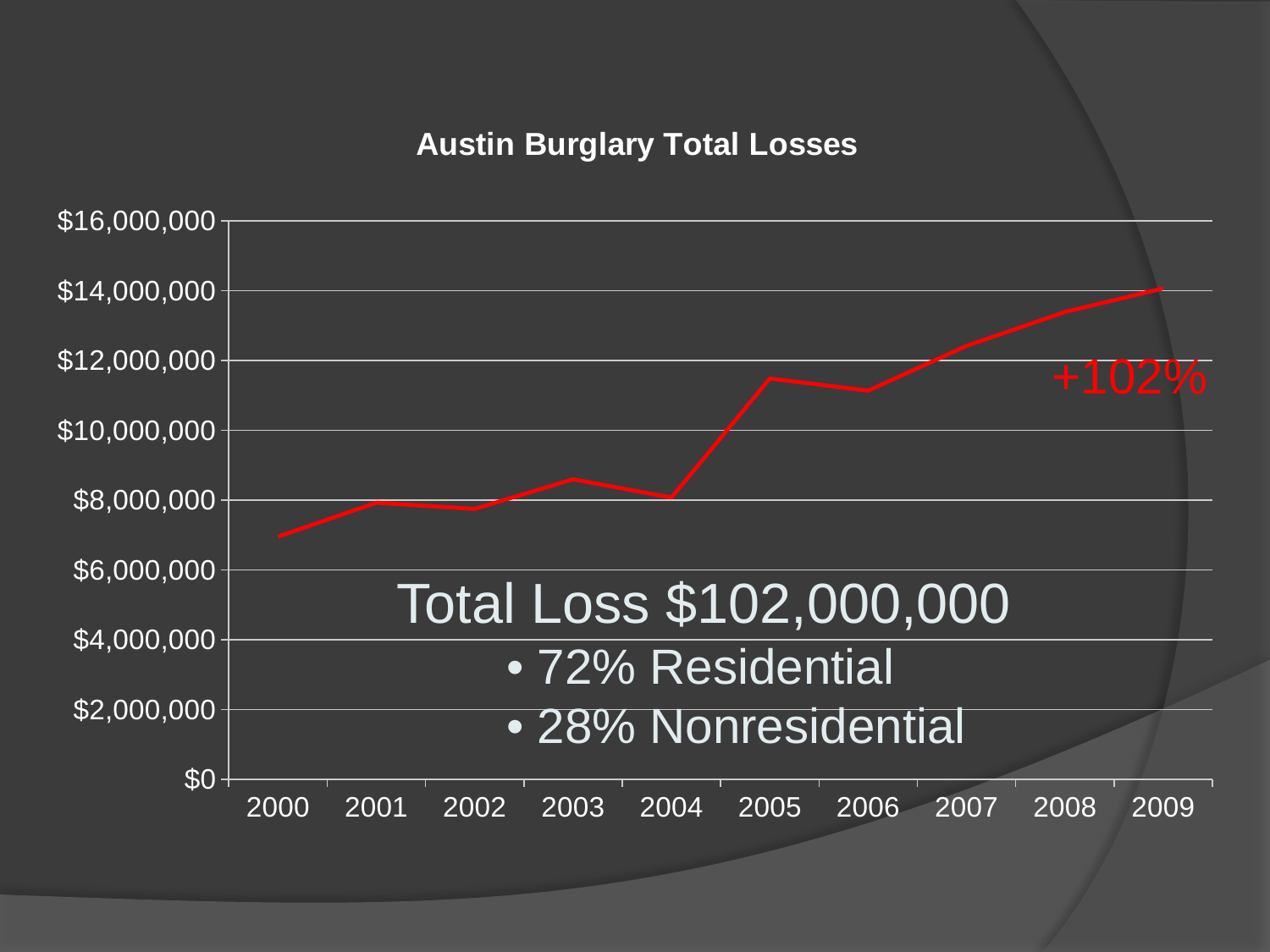
Which year has the lowest total loss? 2000 What percentage change is annotated in red next to the end of the line? +102% Is the value for 2004 greater or less than $10,000,000? less What is the title of the chart? Austin Burglary Total Losses What kind of chart is shown on the slide? line chart Is the value for 2009 greater or less than $12,000,000? greater Which year has the larger total loss, 2004 or 2005? 2005 Is the value for 2005 greater or less than $10,000,000? greater Do total losses generally rise or fall from 2000 to 2009? rise Which year has the highest total loss? 2009 How many years are plotted along the x axis? 10